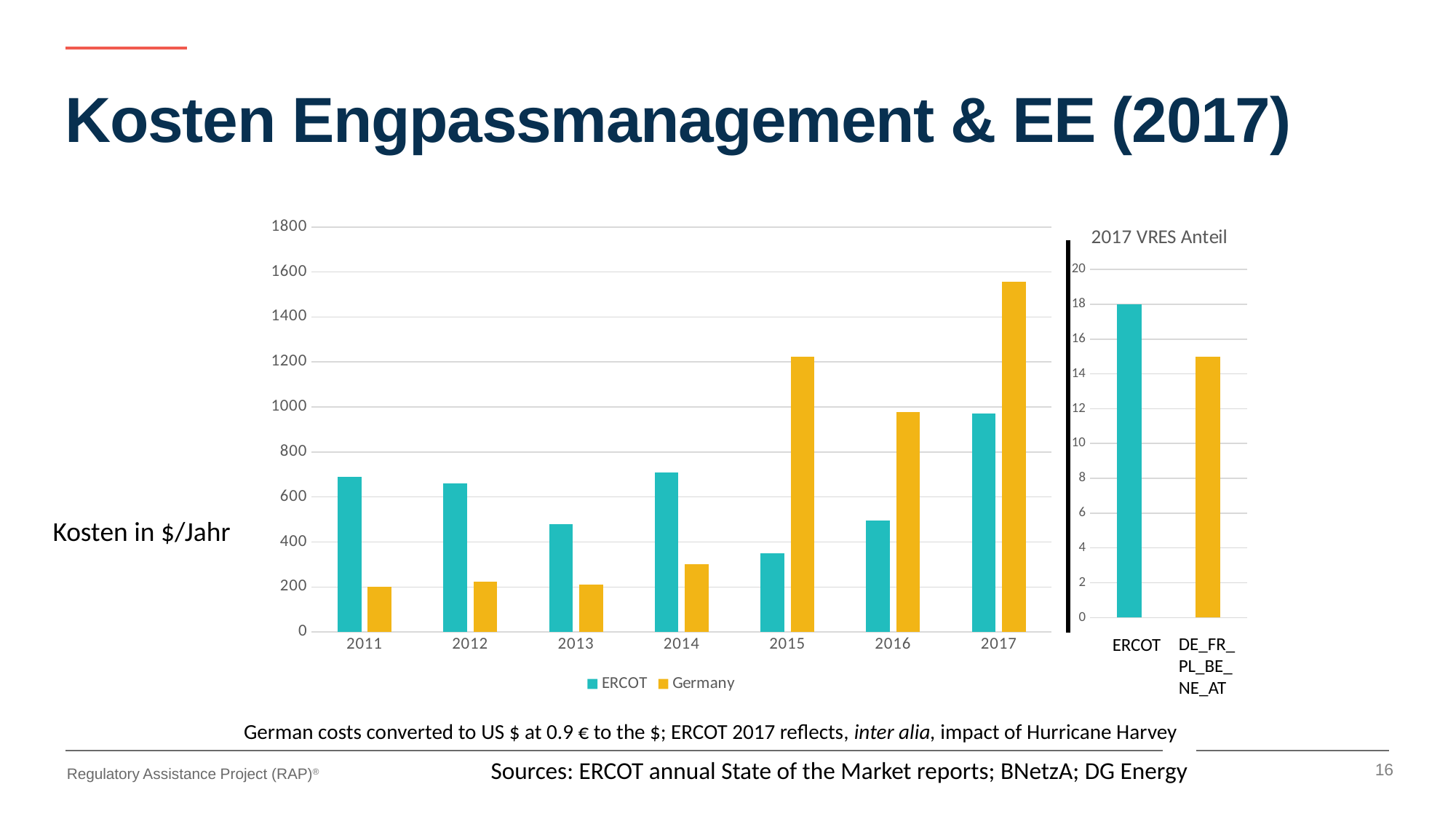
In the main chart (Kosten in $/Jahr), what colour are the Germany bars? Yellow In the main chart (Kosten in $/Jahr), does the Germany value rise or fall from 2016 to 2017? rise In the main chart (Kosten in $/Jahr), in which year is the ERCOT value lowest? 2015 In the 2017 VRES Anteil chart, is the value for DE_FR_PL_BE_NE_AT greater or less than 16? less In the main chart (Kosten in $/Jahr), how many series does the legend list? 2 In the 2017 VRES Anteil chart, which category has the higher value, ERCOT or DE_FR_PL_BE_NE_AT? ERCOT In the main chart (Kosten in $/Jahr), is the Germany value for 2017 greater or less than 1400? greater In the main chart (Kosten in $/Jahr), in which year is the Germany value highest? 2017 What kind of chart is the main chart showing Kosten in $/Jahr? Bar chart In the main chart (Kosten in $/Jahr), is the ERCOT value for 2011 greater or less than 600? greater In the main chart (Kosten in $/Jahr), how many years are shown on the x axis? 7 In the main chart (Kosten in $/Jahr), which series has the larger value in 2015, ERCOT or Germany? Germany